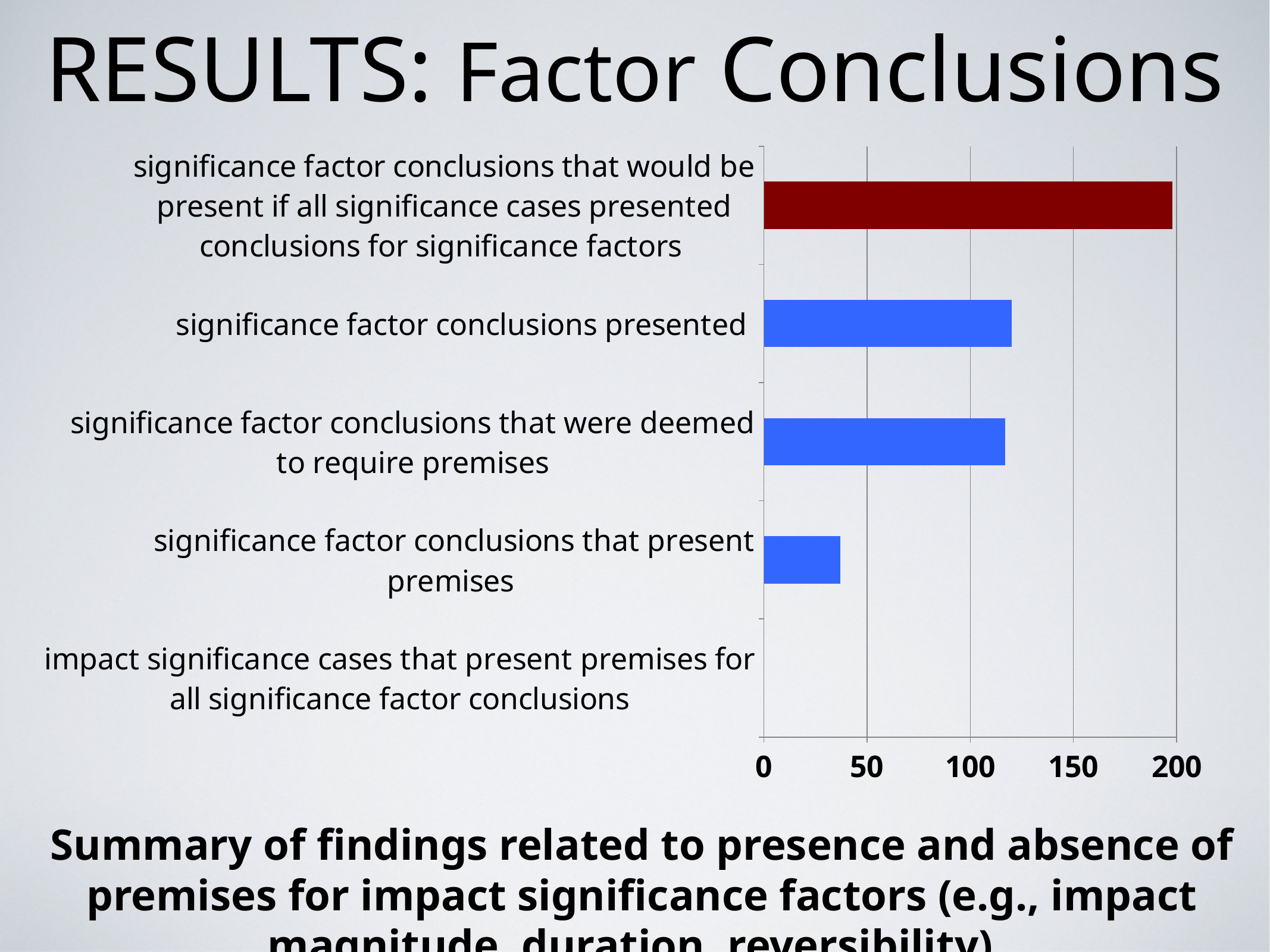
Is the value for 'significance factor conclusions that would be present if all significance cases presented conclusions for significance factors' greater or less than 150? greater Which is larger: the value for 'significance factor conclusions presented' or the value for 'significance factor conclusions that present premises'? significance factor conclusions presented What kind of chart is shown on the slide? bar chart Which category has the highest value? significance factor conclusions that would be present if all significance cases presented conclusions for significance factors What colour is the bar for the highest category? dark red How many categories are plotted in the chart? 5 Which category has the lowest value? impact significance cases that present premises for all significance factor conclusions Is the value for 'significance factor conclusions that present premises' greater or less than 50? less What is the highest tick value shown on the horizontal axis? 200 Which is larger: the value for 'significance factor conclusions that would be present if all significance cases presented conclusions for significance factors' or the value for 'significance factor conclusions that were deemed to require premises'? significance factor conclusions that would be present if all significance cases presented conclusions for significance factors Is the value for 'significance factor conclusions that were deemed to require premises' greater or less than 150? less